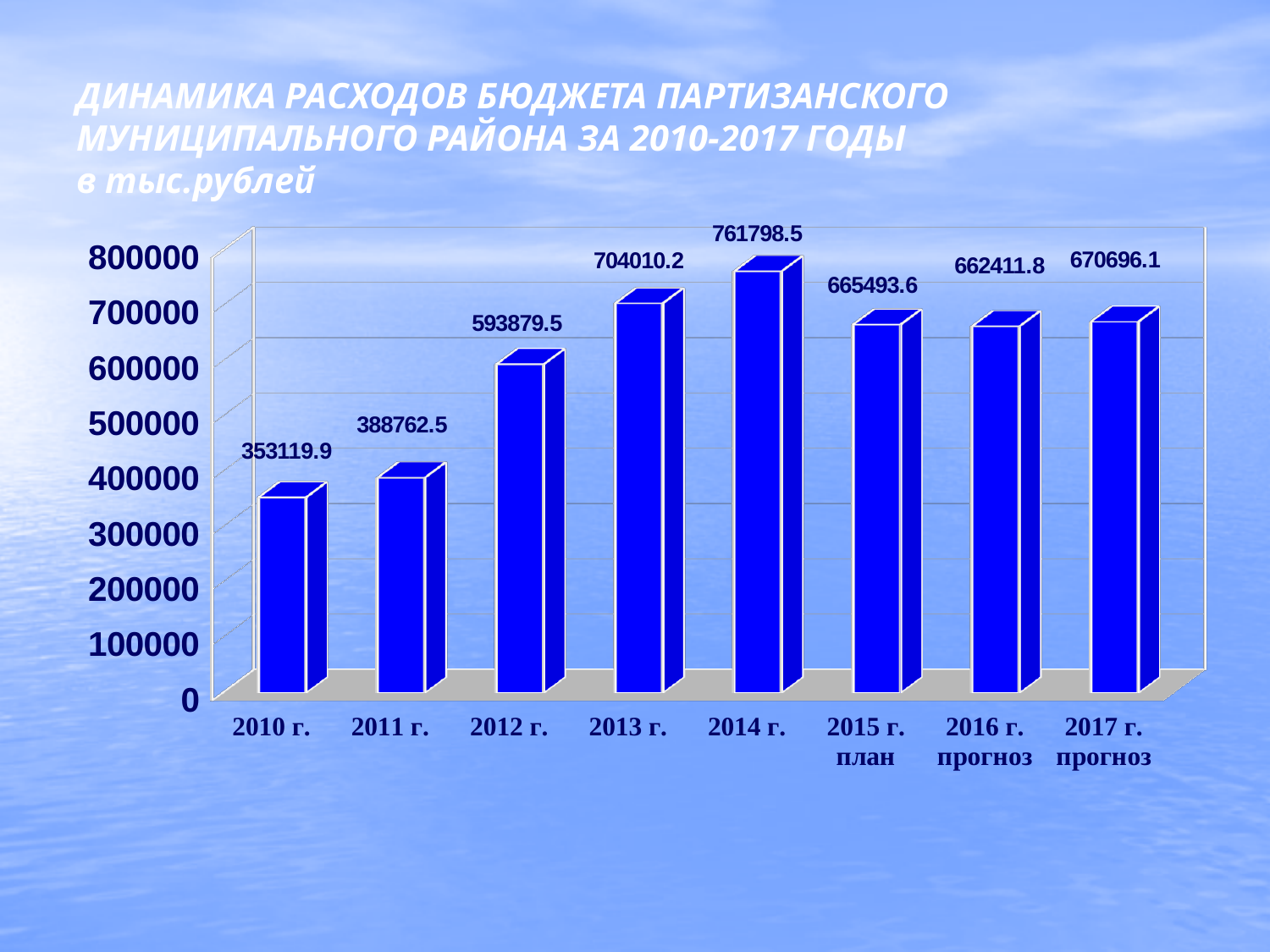
What kind of chart is shown on the slide? bar chart Do the values rise or fall from 2010 г. to 2014 г.? rise What is the difference between the values for 2013 г. and 2012 г.? 110130.7 What is the budget expenditure value shown for 2010 г.? 353119.9 Which is larger, the value for 2013 г. or the value for 2017 г. прогноз? 2013 г. What is the difference between the values for 2014 г. and 2010 г.? 408678.6 What value is labelled on the bar for 2014 г.? 761798.5 Is the value for 2012 г. greater or less than 500000? greater What is the value shown for 2016 г. прогноз? 662411.8 How many bars (categories) are shown on the chart? 8 Which year has the lowest bar on the chart? 2010 г. Which year has the highest bar on the chart? 2014 г.